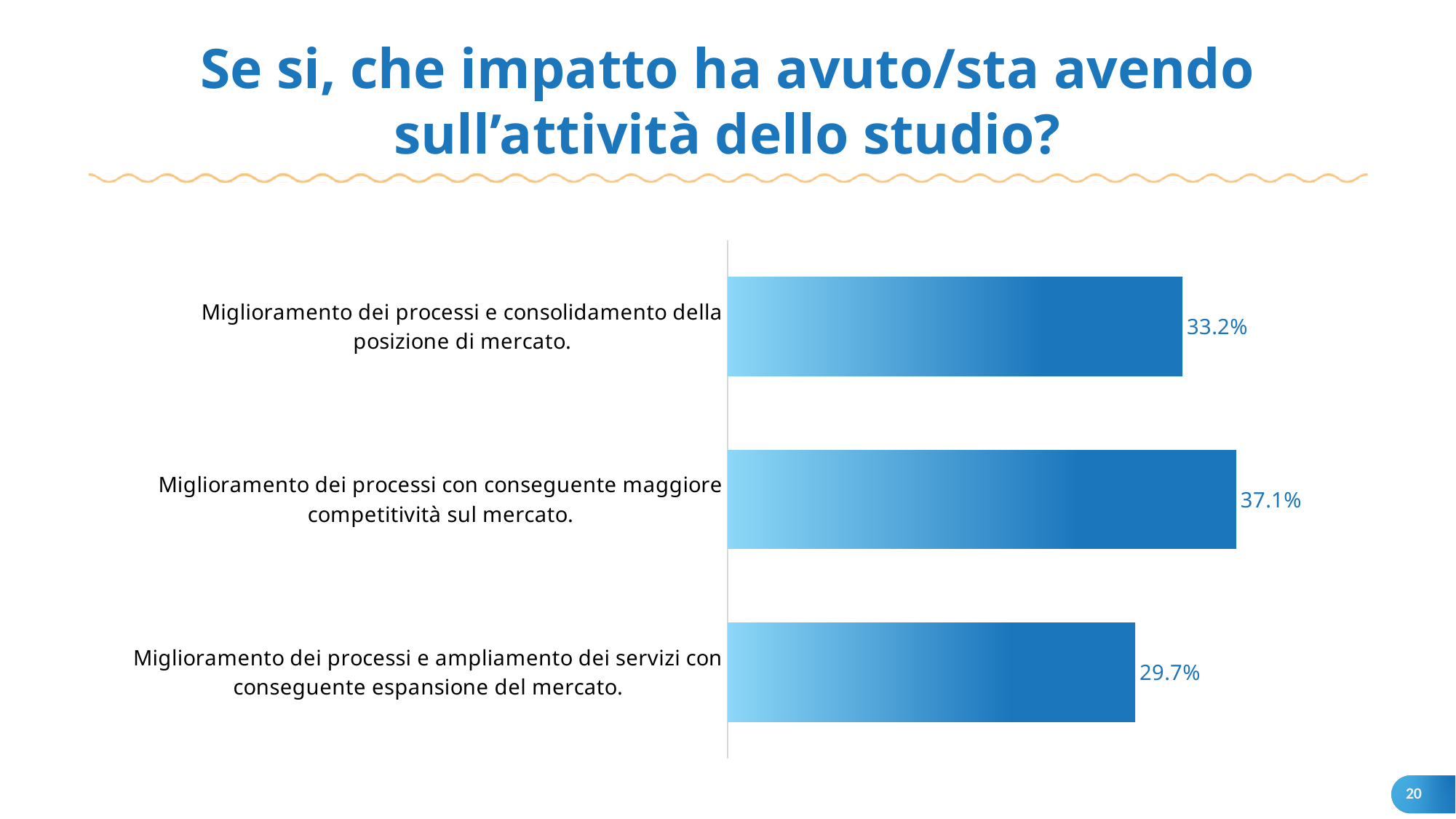
What is the difference between the values for "Miglioramento dei processi con conseguente maggiore competitività sul mercato." and "Miglioramento dei processi e consolidamento della posizione di mercato."? 3.9% What is the value for "Miglioramento dei processi e ampliamento dei servizi con conseguente espansione del mercato."? 29.7% Which category has the lowest value? Miglioramento dei processi e ampliamento dei servizi con conseguente espansione del mercato. Which category has the highest value? Miglioramento dei processi con conseguente maggiore competitività sul mercato. What is the value for "Miglioramento dei processi con conseguente maggiore competitività sul mercato."? 37.1% What is the value for "Miglioramento dei processi e consolidamento della posizione di mercato."? 33.2% What is the total of the three values shown in the chart? 100% What is the difference between the values for "Miglioramento dei processi e consolidamento della posizione di mercato." and "Miglioramento dei processi e ampliamento dei servizi con conseguente espansione del mercato."? 3.5% How many categories are shown in the chart? 3 What kind of chart is shown on the slide? Bar chart Which is larger: the value for "Miglioramento dei processi e consolidamento della posizione di mercato." or the value for "Miglioramento dei processi e ampliamento dei servizi con conseguente espansione del mercato."? Miglioramento dei processi e consolidamento della posizione di mercato. What is the title of the slide containing the chart? Se si, che impatto ha avuto/sta avendo sull'attività dello studio?